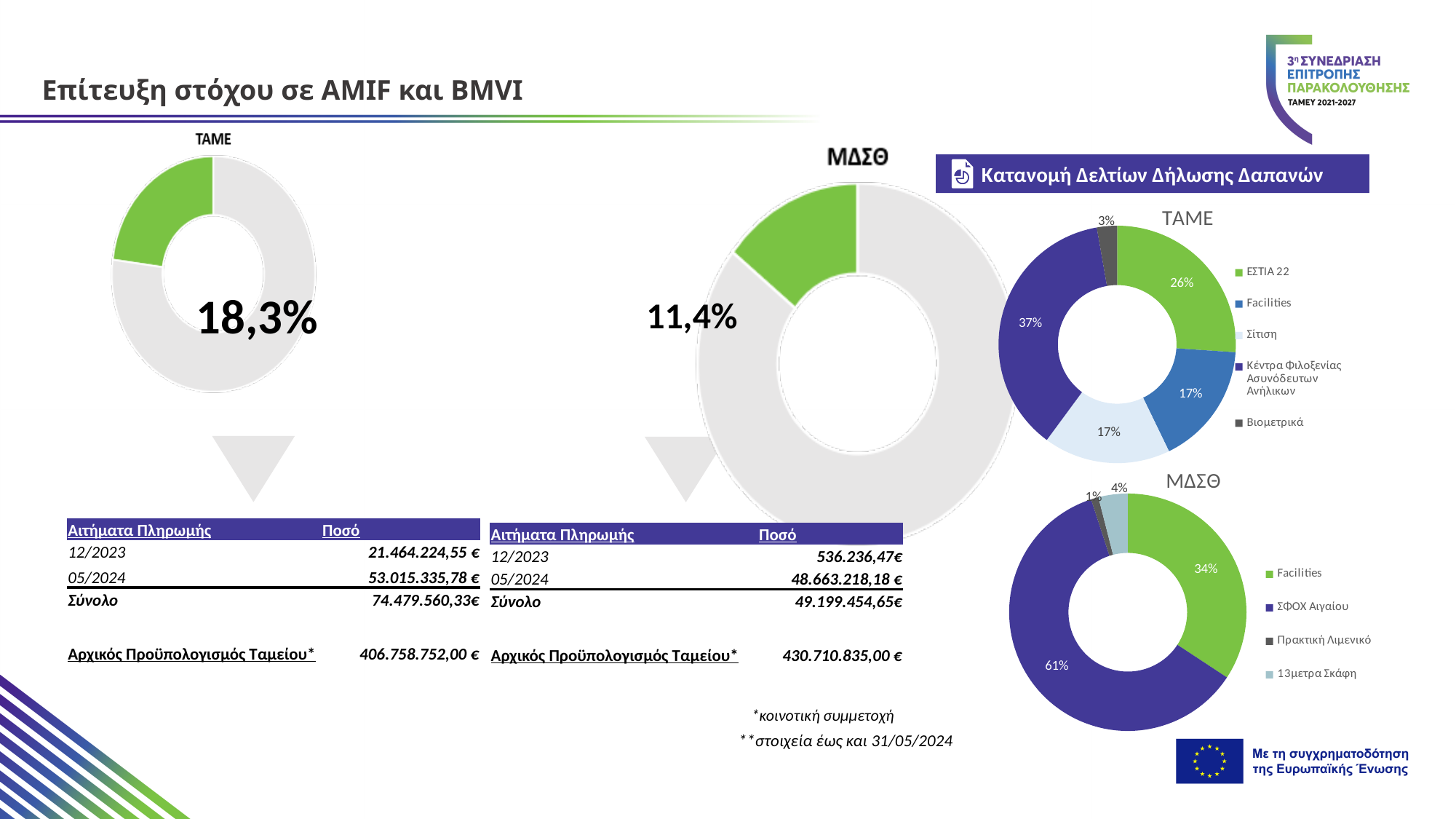
In the 'Κατανομή Δελτίων Δήλωσης Δαπανών' ΜΔΣΘ donut chart, which category has the smallest share? Πρακτική Λιμενικό What percentage is shown in the ΜΔΣΘ donut chart in the centre of the slide? 11,4% In the 'Κατανομή Δελτίων Δήλωσης Δαπανών' ΤΑΜΕ donut chart, which category has the largest share? Κέντρα Φιλοξενίας Ασυνόδευτων Ανήλικων In the 'Κατανομή Δελτίων Δήλωσης Δαπανών' ΜΔΣΘ donut chart, what share does ΣΦΟΧ Αιγαίου have? 61% In the 'Κατανομή Δελτίων Δήλωσης Δαπανών' ΜΔΣΘ donut chart, which is larger: Facilities or ΣΦΟΧ Αιγαίου? ΣΦΟΧ Αιγαίου In the 'Κατανομή Δελτίων Δήλωσης Δαπανών' ΤΑΜΕ donut chart, how many categories does the legend list? 5 In the 'Κατανομή Δελτίων Δήλωσης Δαπανών' ΜΔΣΘ donut chart, what share does 13μετρα Σκάφη have? 4% In the 'Κατανομή Δελτίων Δήλωσης Δαπανών' ΤΑΜΕ donut chart, which category has the smallest share? Βιομετρικά In the 'Κατανομή Δελτίων Δήλωσης Δαπανών' ΤΑΜΕ donut chart, what is the difference between the share of Κέντρα Φιλοξενίας Ασυνόδευτων Ανήλικων and the share of ΕΣΤΙΑ 22? 11% In the 'Κατανομή Δελτίων Δήλωσης Δαπανών' ΤΑΜΕ donut chart, what share does ΕΣΤΙΑ 22 have? 26% What percentage is shown in the ΤΑΜΕ donut chart at the top left of the slide? 18,3% In the 'Κατανομή Δελτίων Δήλωσης Δαπανών' ΜΔΣΘ donut chart, how many categories does the legend list? 4